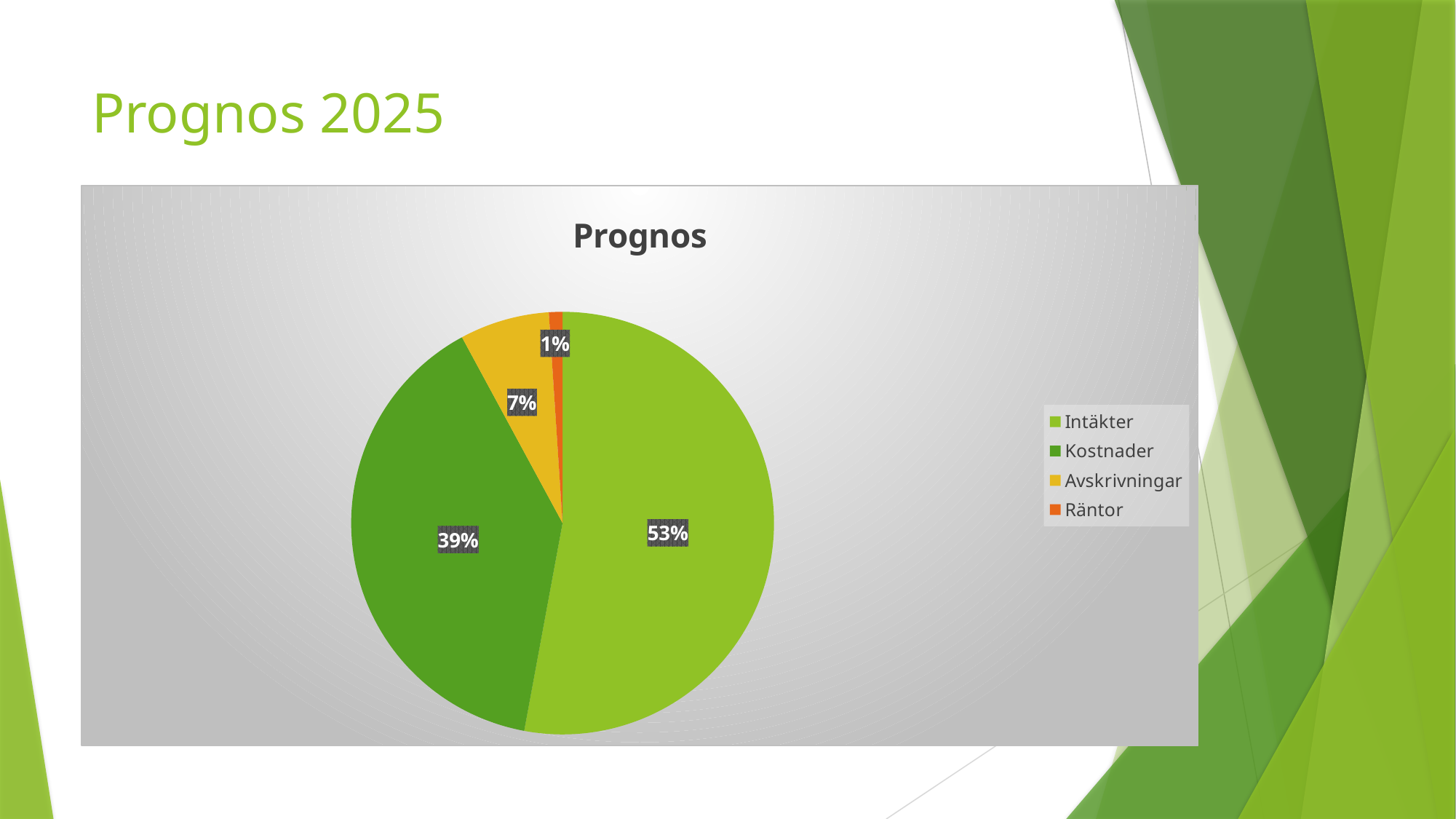
Which category is shown in orange? Räntor What is the difference in percentage points between Intäkter and Kostnader? 14 Which category has the largest slice of the pie? Intäkter What is the title of the chart? Prognos What share of the pie does Intäkter represent? 53% What share of the pie does Kostnader represent? 39% Which category has the smallest slice of the pie? Räntor How many categories does the legend list? 4 Which is larger, the share for Avskrivningar or the share for Räntor? Avskrivningar What share of the pie does Avskrivningar represent? 7% What kind of chart is shown on the slide? pie chart